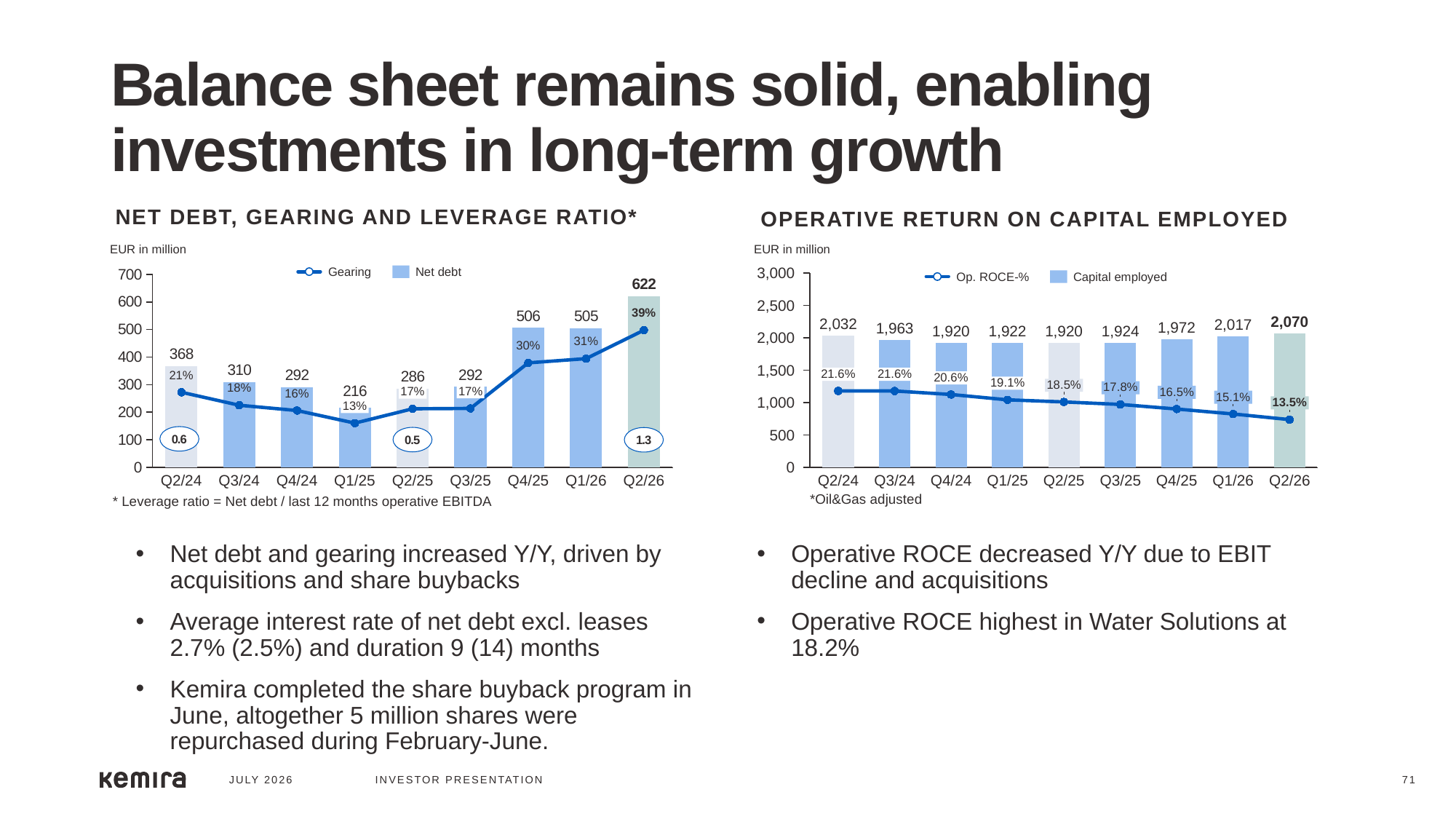
In the 'Net debt, gearing and leverage ratio' chart, what is the gearing for Q1/25? 13% In the 'Net debt, gearing and leverage ratio' chart, what is the leverage ratio shown for Q2/26? 1.3 In the 'Operative return on capital employed' chart, which is larger, the capital employed for Q3/24 or for Q1/26? Q1/26 In the 'Net debt, gearing and leverage ratio' chart, which quarter has the lowest net debt? Q1/25 In the 'Operative return on capital employed' chart, which quarter has the highest capital employed? Q2/26 In the 'Operative return on capital employed' chart, what is the Op. ROCE-% for Q2/26? 13.5% In the 'Operative return on capital employed' chart, what is the capital employed for Q4/25? 1,972 In the 'Net debt, gearing and leverage ratio' chart, how many series does the legend list? 2 In the 'Net debt, gearing and leverage ratio' chart, what is the difference in net debt between Q2/26 and Q2/24? 254 In the 'Operative return on capital employed' chart, how many quarters are shown on the x axis? 9 In the 'Operative return on capital employed' chart, does the Op. ROCE-% rise or fall from Q2/24 to Q2/26? fall In the 'Net debt, gearing and leverage ratio' chart, what is the net debt for Q2/26? 622